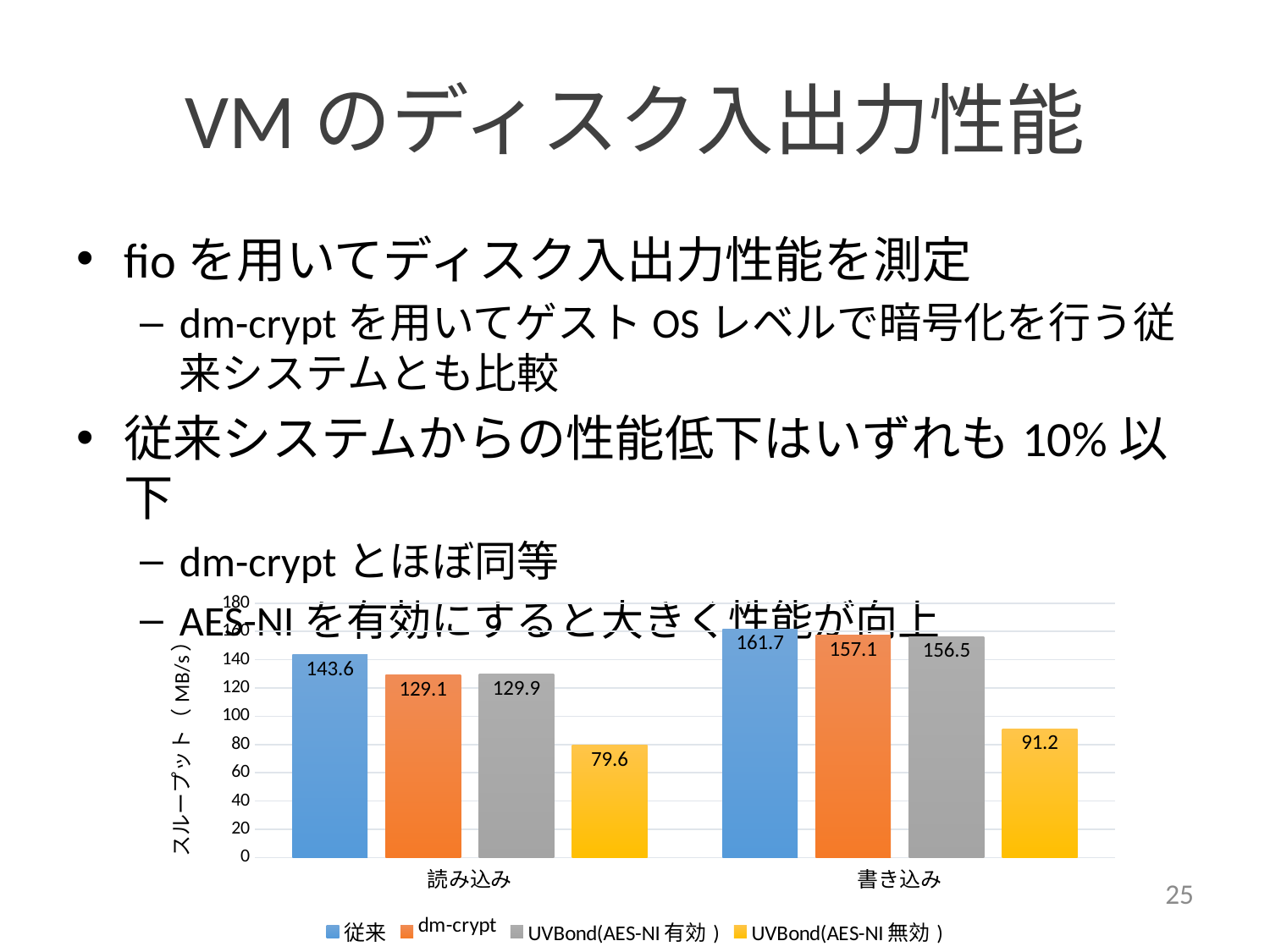
What kind of chart is shown on the slide? bar chart How many series does the chart legend list? 4 What is the throughput for dm-crypt in the 書き込み category? 157.1 How many categories are shown on the x axis of the chart? 2 What is the difference between the 従来 and UVBond(AES-NI 無効) values in the 読み込み category? 64 What is the throughput for 従来 in the 読み込み category? 143.6 Which series has the lowest throughput in the 読み込み category? UVBond(AES-NI 無効) Which is larger in the 書き込み category: the 従来 value or the UVBond(AES-NI 有効) value? 従来 What is the throughput for UVBond(AES-NI 無効) in the 書き込み category? 91.2 Is the value for UVBond(AES-NI 無効) in the 読み込み category greater or less than 100? less What is the label of the y axis of the chart? スループット (MB/s) Which series has the highest throughput in the 書き込み category? 従来